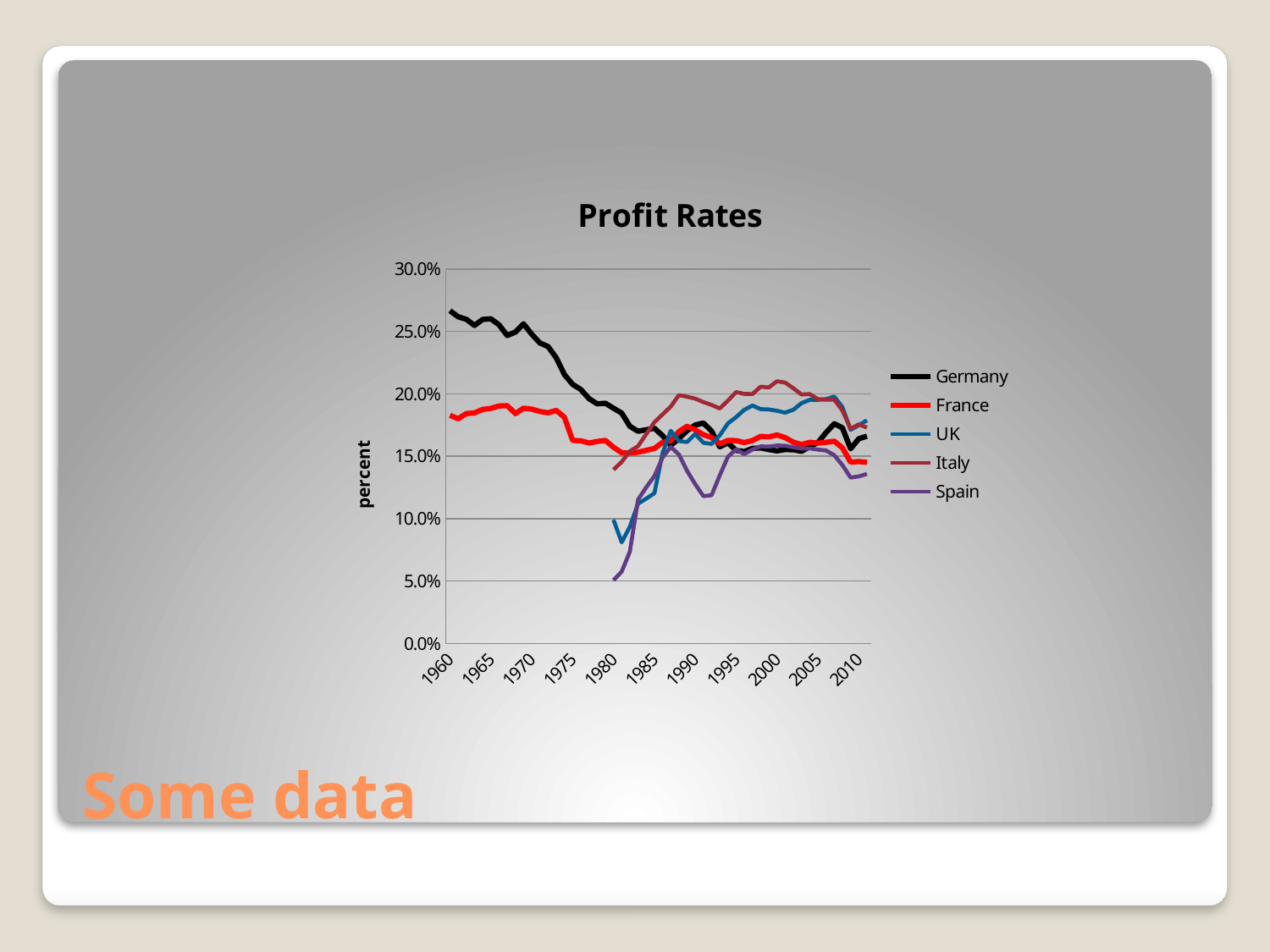
Which series has the lowest profit rate in 1980? Spain What kind of chart is shown on the slide? line chart What is the title of the chart? Profit Rates What is the label on the vertical axis of the chart? percent How many series does the legend of the Profit Rates chart list? 5 Is the value for France in 1960 greater or less than 20.0%? less Does the Germany line rise or fall between 1960 and 1985? fall Which series has the highest profit rate in 1960? Germany Which is larger in 1960, the value for Germany or the value for France? Germany Is the value for Spain in 1980 greater or less than 10.0%? less Is the value for Germany in 1975 greater or less than 25.0%? less